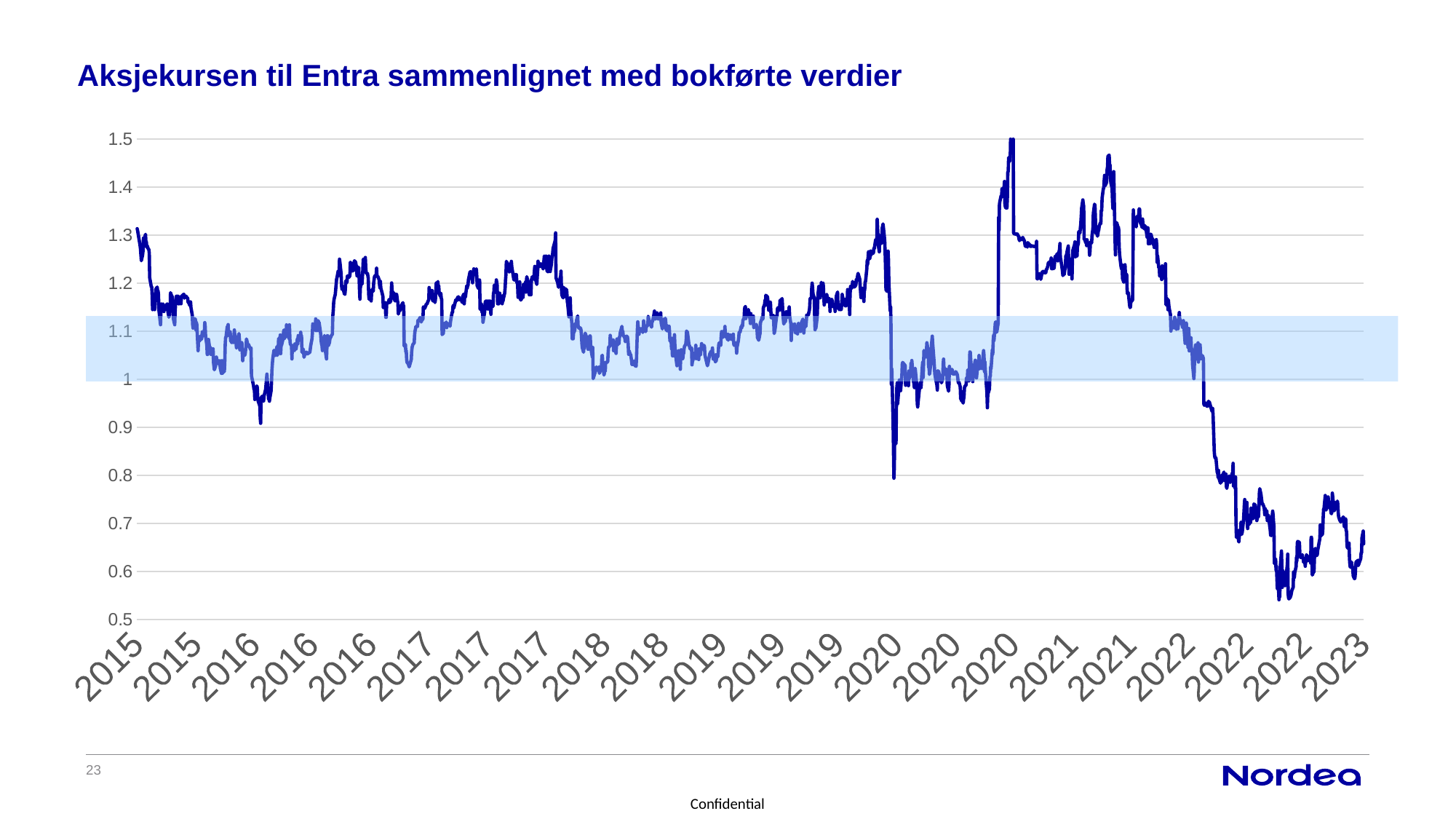
Is the peak reached in 2020 greater or less than 1.4? greater What kind of chart is shown on the slide? Line chart Is the value in mid-2018 greater or less than 1.2? less Which is higher: the value at the start of 2015 or the value at the end of the series in 2023? Start of 2015 Is the sharp dip in early 2020 greater or less than 0.9? less How many distinct years are labelled on the x-axis? 9 What is the highest value shown on the y-axis? 1.5 Overall, does the line rise or fall from the start of 2015 to the end of the series in 2023? Fall What is the title of the chart? Aksjekursen til Entra sammenlignet med bokførte verdier